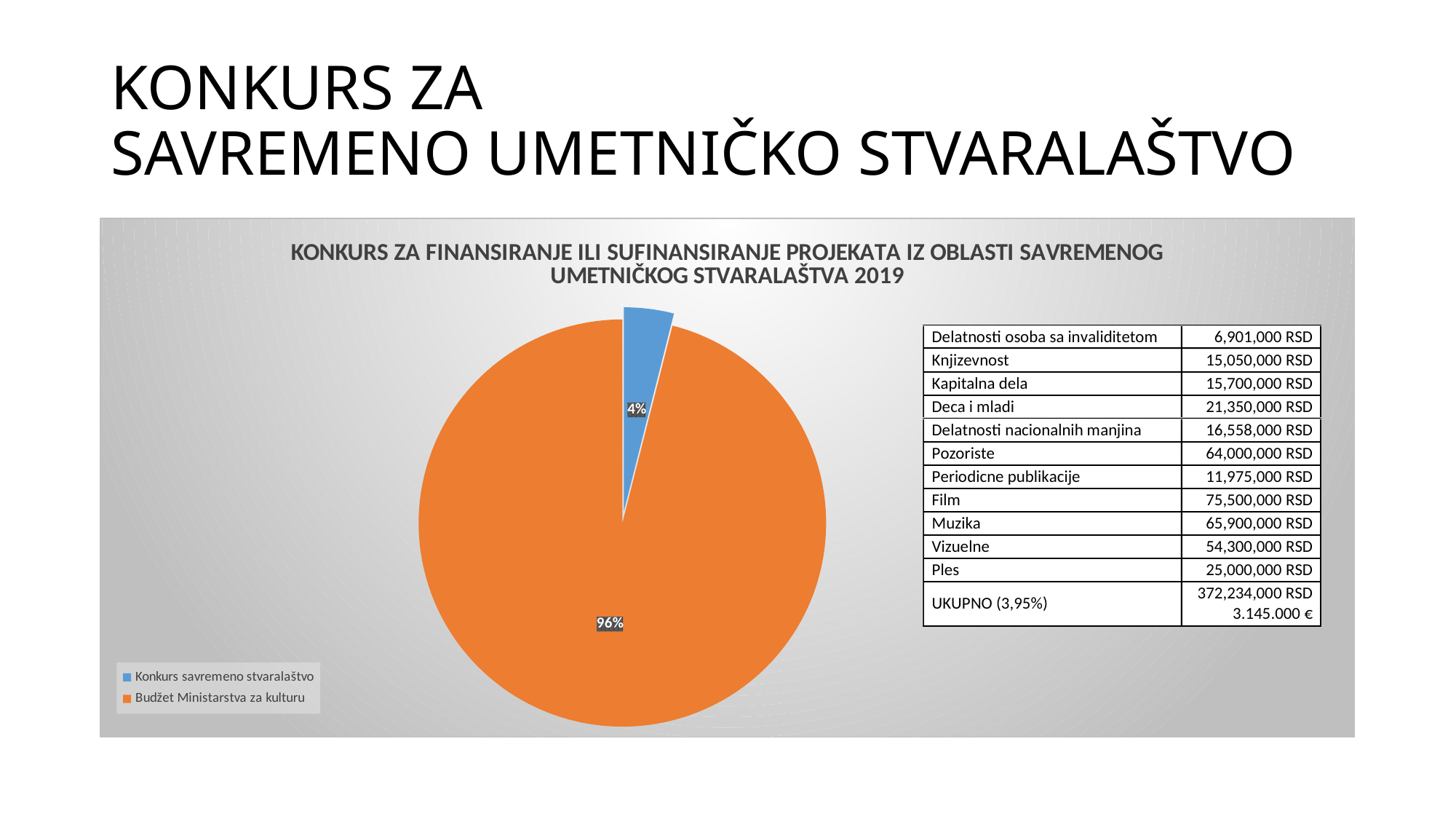
How many entries does the legend list? 2 What share of the pie does Budžet Ministarstva za kulturu represent? 96% How many slices does the pie chart have? 2 What colour is the Konkurs savremeno stvaralaštvo slice? blue What is the difference in percentage points between the Budžet Ministarstva za kulturu slice and the Konkurs savremeno stvaralaštvo slice? 92 What share of the pie does Konkurs savremeno stvaralaštvo represent? 4% Which slice of the pie is the smallest? Konkurs savremeno stvaralaštvo What colour is the Budžet Ministarstva za kulturu slice? orange Which is larger, the Konkurs savremeno stvaralaštvo slice or the Budžet Ministarstva za kulturu slice? Budžet Ministarstva za kulturu Which slice of the pie is the largest? Budžet Ministarstva za kulturu What kind of chart is shown on the slide? pie chart